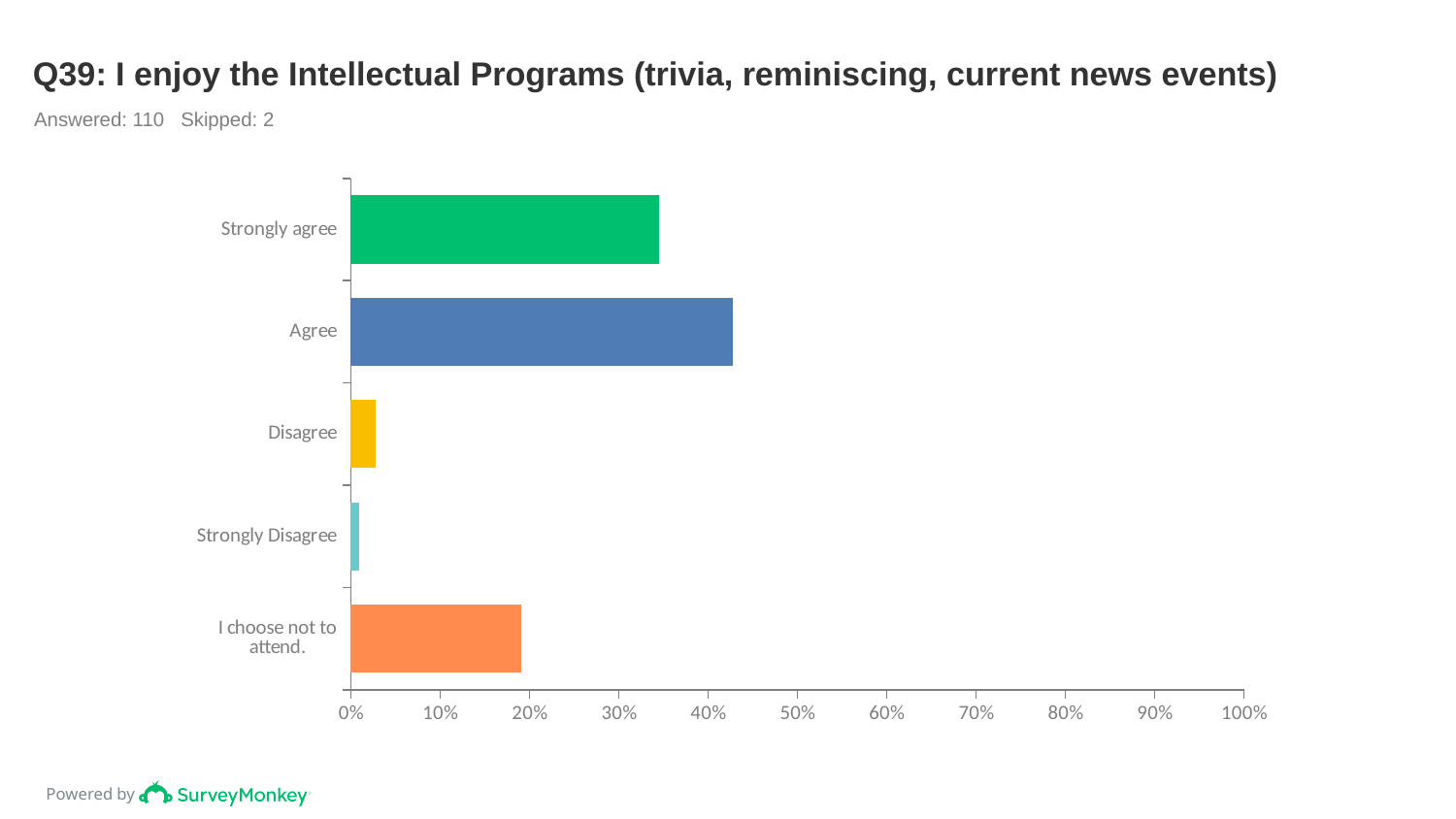
Is the value for I choose not to attend. greater or less than 10%? greater What kind of chart is shown on the slide? bar chart Which response category has the highest value? Agree How many respondents answered this question according to the slide? 110 Is the value for Disagree greater or less than 10%? less Which is larger, the value for Strongly agree or the value for Agree? Agree Which is larger, the value for Disagree or the value for I choose not to attend.? I choose not to attend. Is the value for Agree greater or less than 50%? less How many response categories are shown on the chart? 5 Which response category has the lowest value? Strongly Disagree